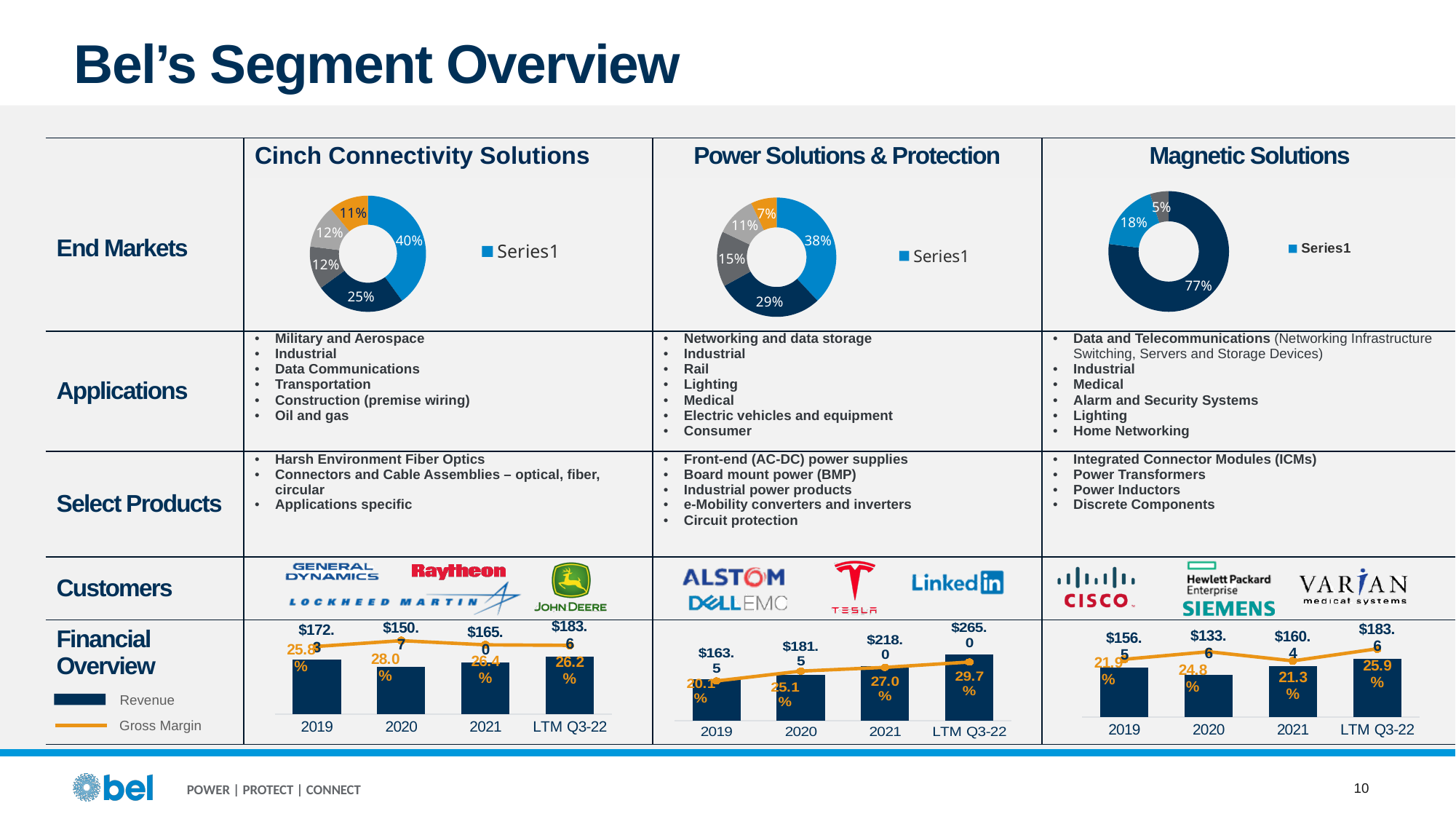
In the Power Solutions & Protection Financial Overview chart, which period has the highest gross margin? LTM Q3-22 What kind of chart is used for the Cinch Connectivity Solutions End Markets? donut (pie) chart In the Cinch Connectivity Solutions Financial Overview chart, which year has the higher gross margin, 2019 or 2020? 2020 In the Cinch Connectivity Solutions Financial Overview chart, what is the revenue for 2021? $165.0 In the Financial Overview charts, what does the orange line represent according to the legend? Gross Margin How many slices does the Power Solutions & Protection End Markets donut chart have? 5 In the Cinch Connectivity Solutions Financial Overview chart, what is the difference between revenue in LTM Q3-22 and revenue in 2020? $32.9 In the Magnetic Solutions End Markets donut chart, what share does the largest slice have? 77% In the Power Solutions & Protection Financial Overview chart, what is the revenue for LTM Q3-22? $265.0 In the Magnetic Solutions Financial Overview chart, which period has the lowest revenue? 2020 In the Power Solutions & Protection Financial Overview chart, does revenue rise or fall from 2019 to LTM Q3-22? rise In the Magnetic Solutions Financial Overview chart, what is the gross margin for 2020? 24.8%